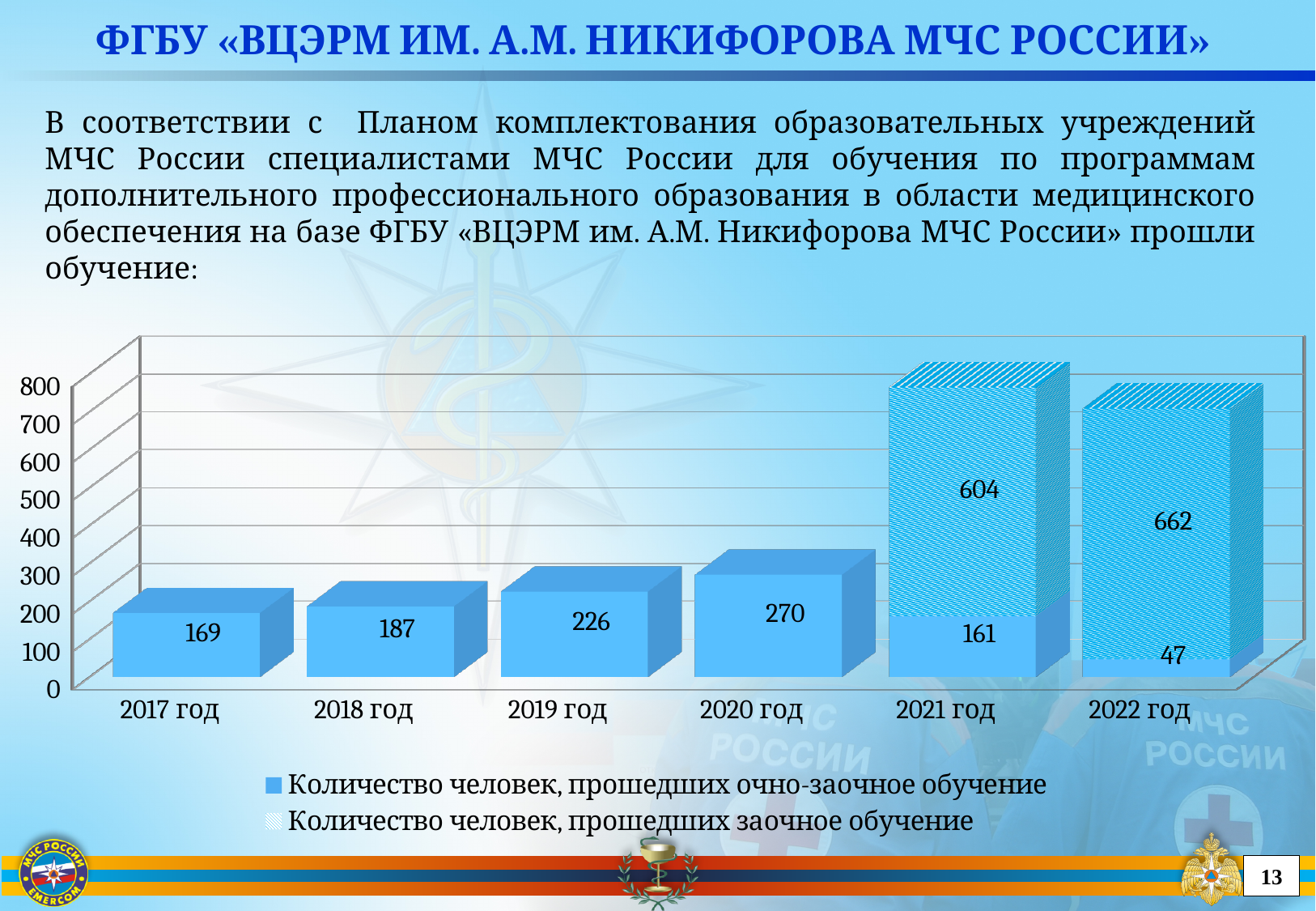
What is the value for 2017 год for the series «Количество человек, прошедших очно-заочное обучение»? 169 What is the value for 2022 год for the series «Количество человек, прошедших очно-заочное обучение»? 47 How many years (categories) are shown on the x axis? 6 What is the total of the stacked bar for 2021 год? 765 Which year has the lowest value for the series «Количество человек, прошедших очно-заочное обучение»? 2022 год What is the value for 2020 год for the series «Количество человек, прошедших очно-заочное обучение»? 270 What is the total of the stacked bar for 2022 год? 709 Which is larger: the «заочное обучение» value for 2021 год or for 2022 год? 2022 год Which year has the highest value for the series «Количество человек, прошедших очно-заочное обучение»? 2020 год What is the difference between the 2020 год and 2019 год values for the series «Количество человек, прошедших очно-заочное обучение»? 44 What is the value for 2021 год for the series «Количество человек, прошедших заочное обучение»? 604 How many series does the legend list? 2